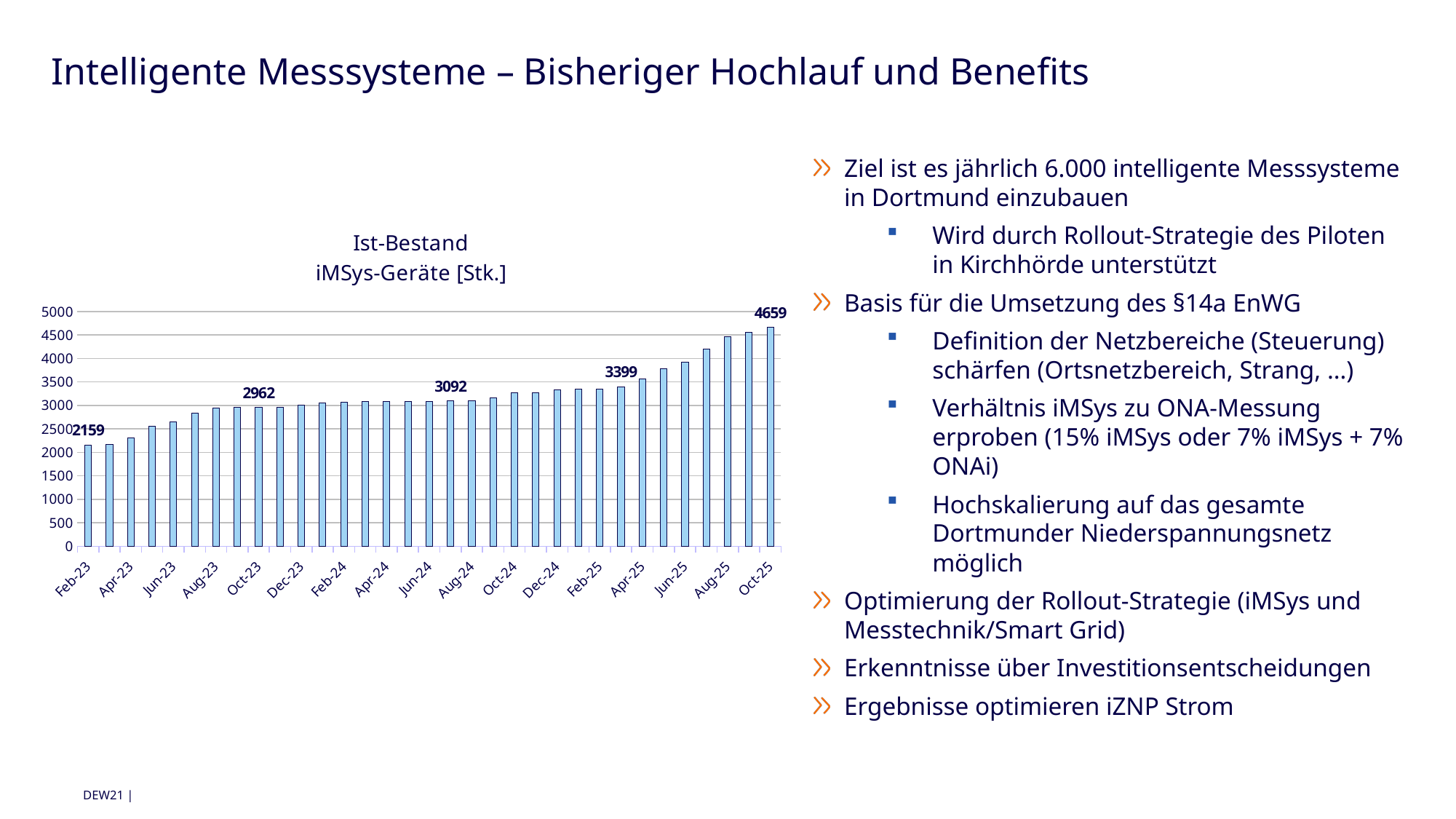
What type of chart is shown on the slide? Bar chart Is the value for Aug-23 greater or less than 2500? greater Do the values generally rise or fall from Feb-23 to Oct-25? Rise What is the title of the chart? Ist-Bestand iMSys-Geräte [Stk.] What is the value for Feb-23? 2159 What is the difference between the values for Oct-25 and Feb-23? 2500 Which month has the highest value? Oct-25 How many bars are plotted in the chart? 33 Is the value for Dec-24 greater or less than 3500? less What is the value for Oct-25? 4659 Is the value for Aug-25 greater or less than 4000? greater Which is larger, the value for Jun-25 or the value for Jun-24? Jun-25